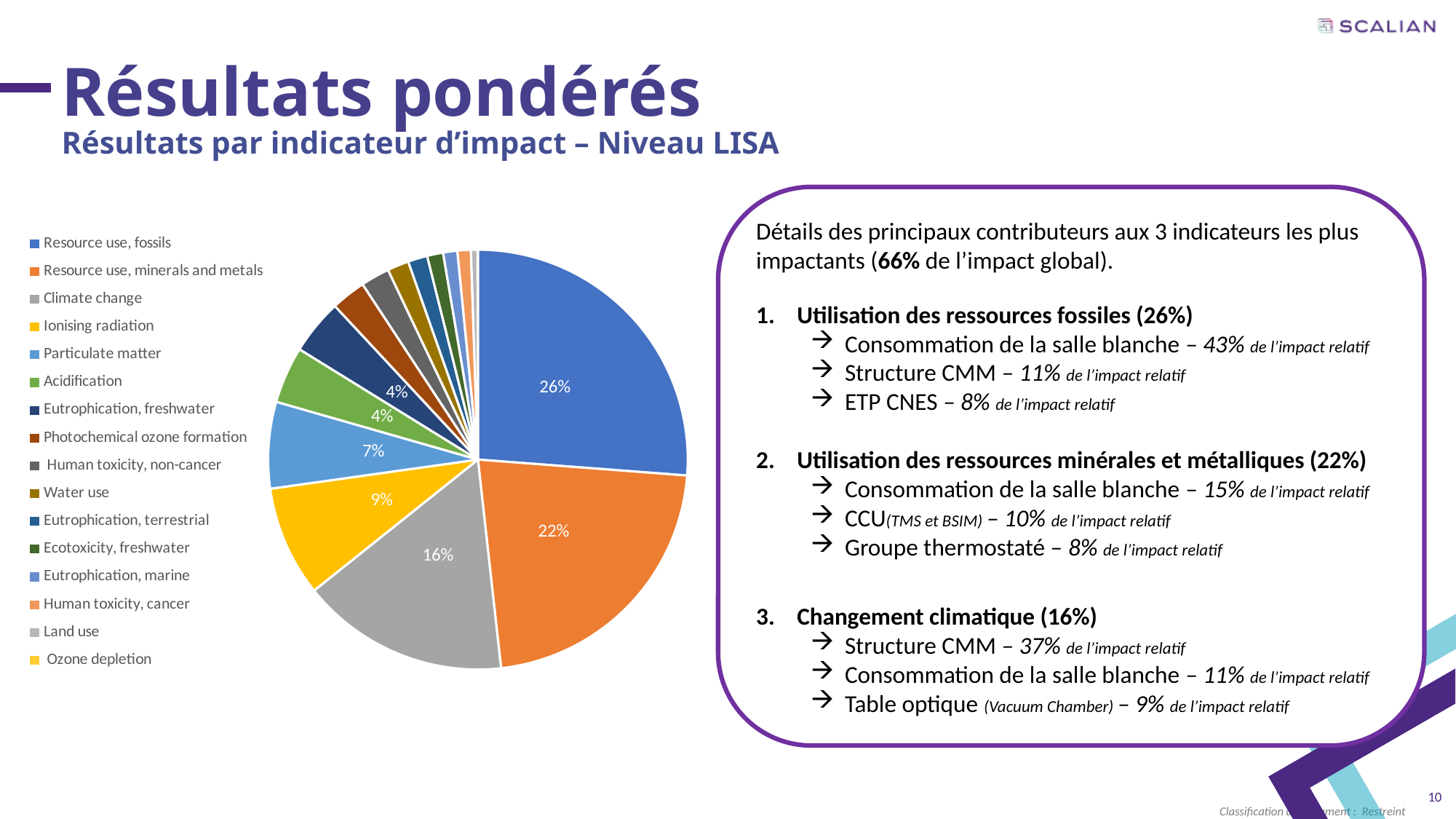
What share of the pie does Resource use, fossils represent? 26% What is the value shown for Particulate matter? 7% How many categories does the legend list? 16 What is the value shown for Resource use, minerals and metals? 22% What colour is the slice for Climate change? grey What kind of chart is shown on the slide? pie chart Which is larger, the share for Ionising radiation or the share for Particulate matter? Ionising radiation What is the difference between the shares of Resource use, fossils and Climate change? 10% What is the value shown for Climate change? 16% What is the value shown for Acidification? 4% Which category has the largest slice of the pie? Resource use, fossils What is the value shown for Ionising radiation? 9%